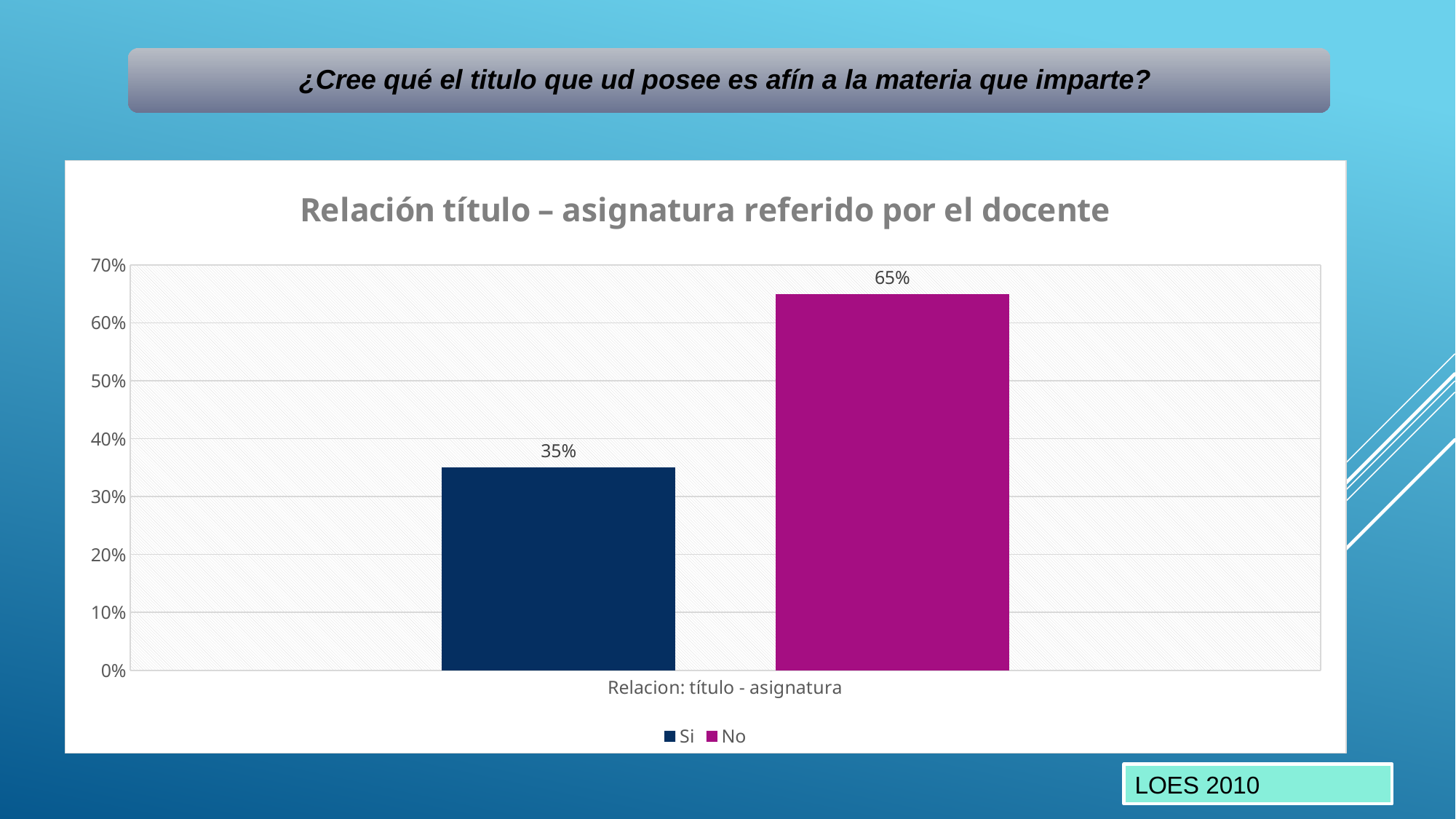
Which is larger, the value for Si or the value for No? No What kind of chart is shown on the slide? Bar chart How many bars are plotted in the chart? 2 What is the difference between the values for No and Si? 30% How many series does the legend list? 2 What is the value for Si? 35% What is the value for No? 65% Is the value for No greater or less than 60%? greater Which series has the lowest value? Si What is the title of the chart? Relación título – asignatura referido por el docente Which series has the highest value? No Is the value for Si greater or less than 40%? less